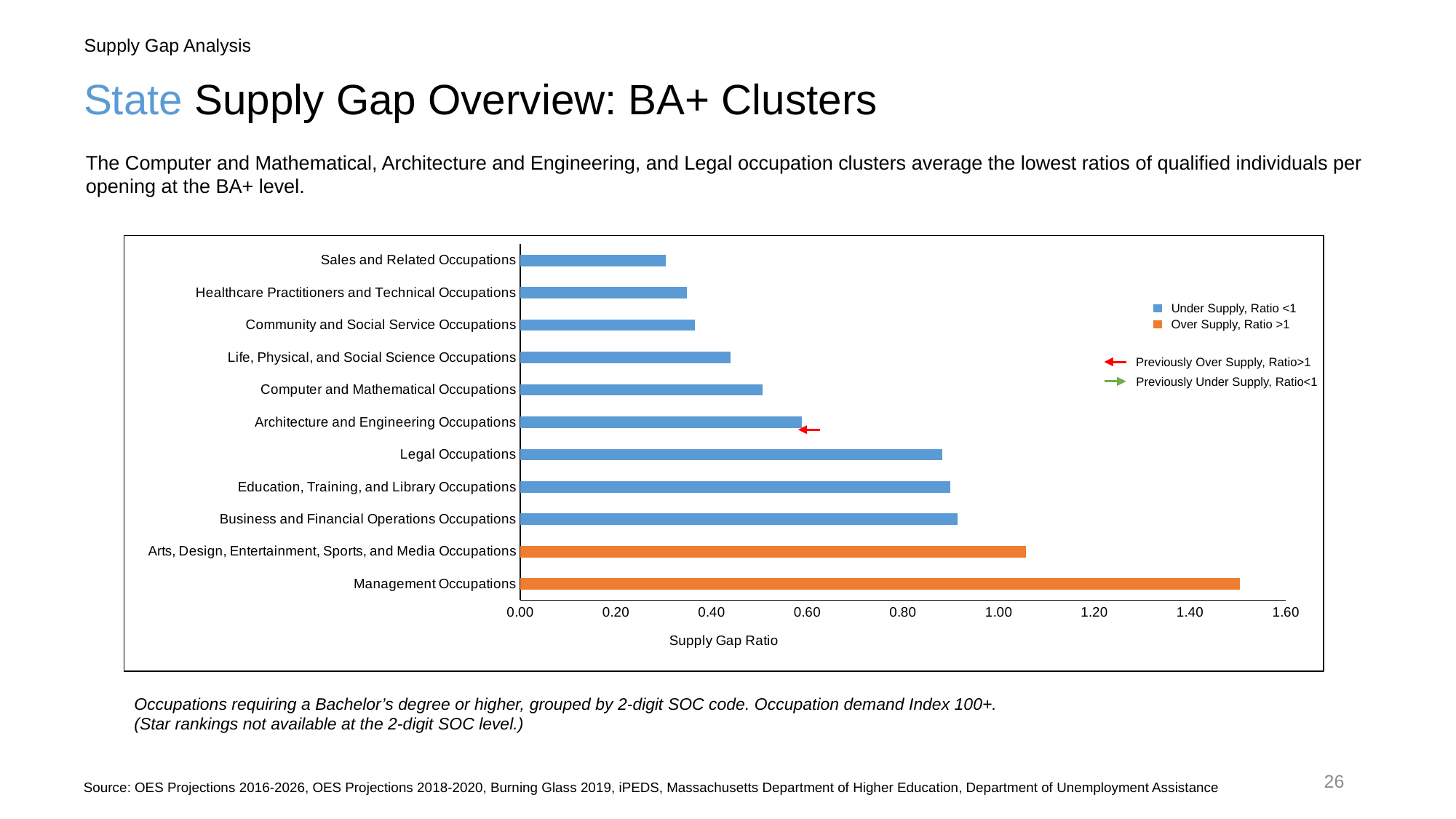
Is the supply gap ratio for Management Occupations greater or less than 1.40? greater Is the supply gap ratio for Legal Occupations greater or less than 0.80? greater Which occupation cluster has the highest supply gap ratio? Management Occupations Which occupation cluster is marked with a red arrow indicating it was previously over supply? Architecture and Engineering Occupations How many occupation clusters are plotted in the chart? 11 Is the supply gap ratio for Sales and Related Occupations greater or less than 0.40? less Which occupation cluster has the lowest supply gap ratio? Sales and Related Occupations Which has a larger supply gap ratio: Legal Occupations or Computer and Mathematical Occupations? Legal Occupations What kind of chart is shown on the slide? bar chart What is the title of the horizontal axis of the chart? Supply Gap Ratio Which has a larger supply gap ratio: Management Occupations or Arts, Design, Entertainment, Sports, and Media Occupations? Management Occupations